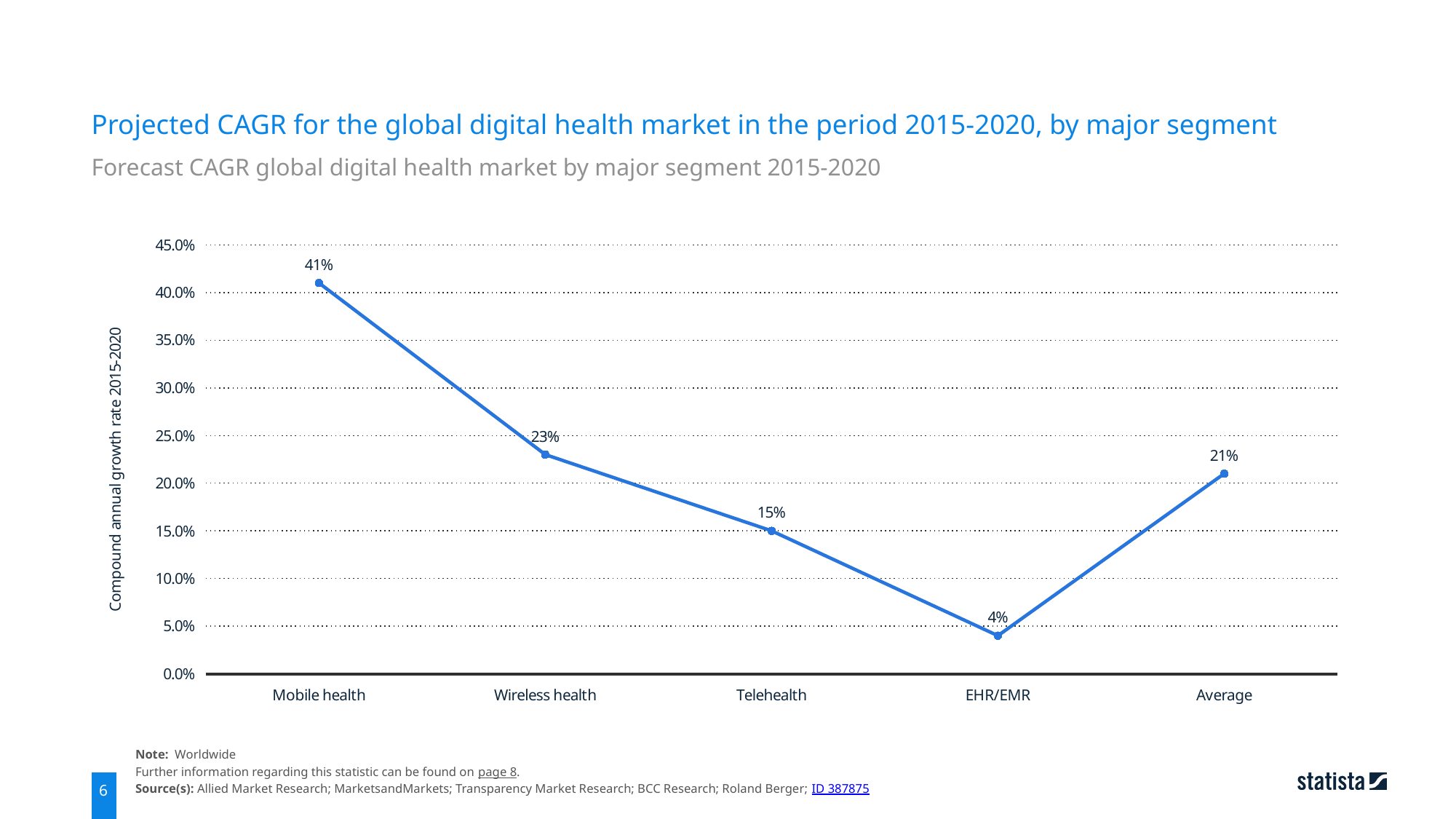
What is the projected CAGR for Telehealth? 15% What is the projected CAGR for EHR/EMR? 4% What is the projected CAGR for Mobile health? 41% How many categories are plotted on the x axis? 5 What is the difference between the CAGR for Mobile health and Wireless health? 18% What is the label of the y axis? Compound annual growth rate 2015-2020 Which segment has the highest projected CAGR? Mobile health Which segment has the lowest projected CAGR? EHR/EMR Is the value for Telehealth greater or less than 20.0%? less Which has a higher projected CAGR, Wireless health or Average? Wireless health What kind of chart is shown on the slide? Line chart Do the values rise or fall from Mobile health to EHR/EMR? Fall